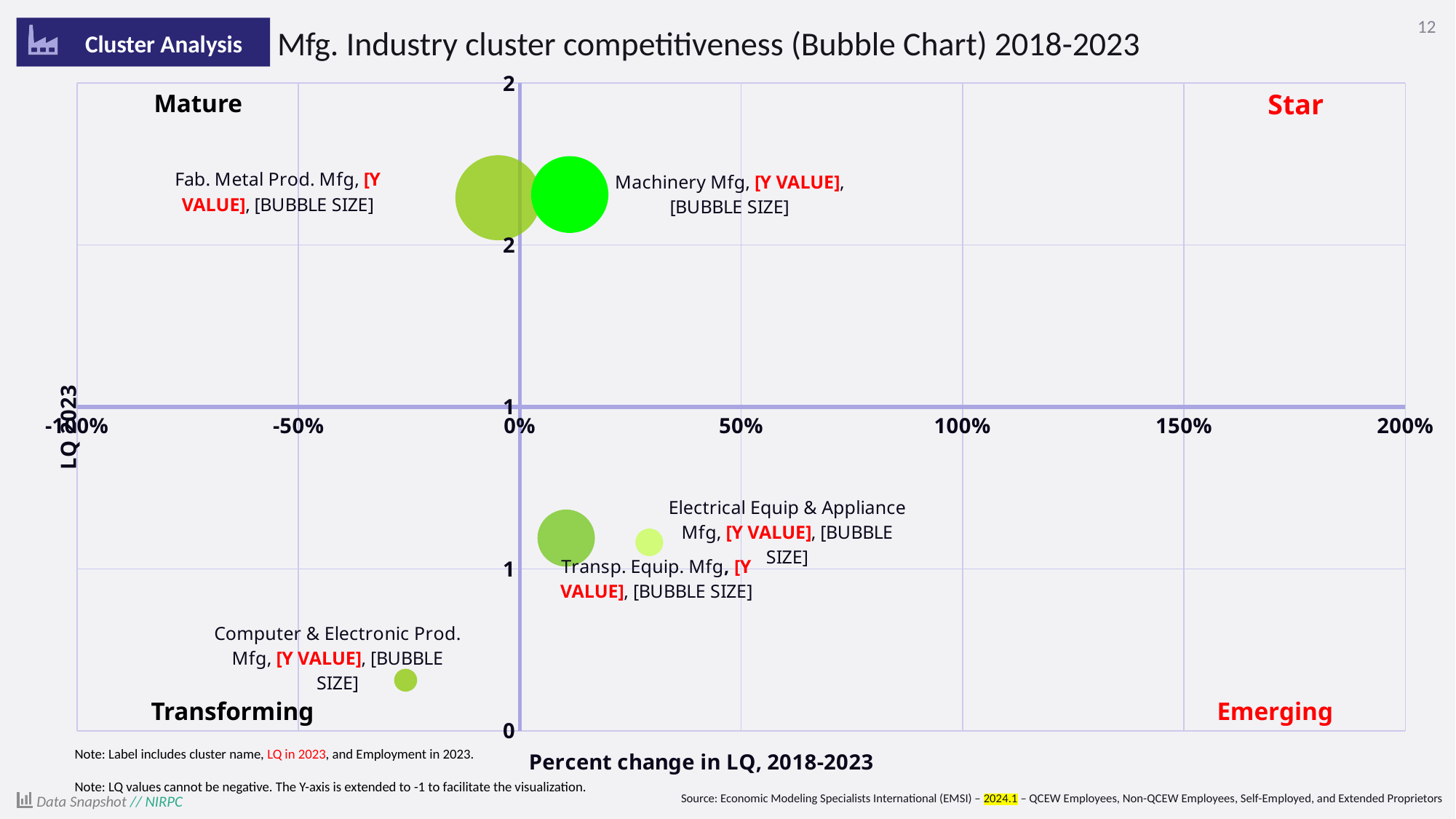
Is the percent change in LQ for Computer & Electronic Prod. Mfg greater or less than 0%? less Is the LQ 2023 value for Machinery Mfg greater or less than 1? greater Which cluster has the lowest percent change in LQ, 2018-2023? Computer & Electronic Prod. Mfg Is the percent change in LQ for Electrical Equip & Appliance Mfg greater or less than 50%? less What is the x-axis title of the chart? Percent change in LQ, 2018-2023 Which cluster has the highest percent change in LQ, 2018-2023? Electrical Equip & Appliance Mfg Which cluster has the lowest LQ in 2023 on the chart? Computer & Electronic Prod. Mfg Which has the higher LQ in 2023: Fab. Metal Prod. Mfg or Computer & Electronic Prod. Mfg? Fab. Metal Prod. Mfg How many bubbles (industry clusters) are plotted on the chart? 5 What is the title of the chart? Mfg. Industry cluster competitiveness (Bubble Chart) 2018-2023 What kind of chart is shown on the slide? Bubble chart